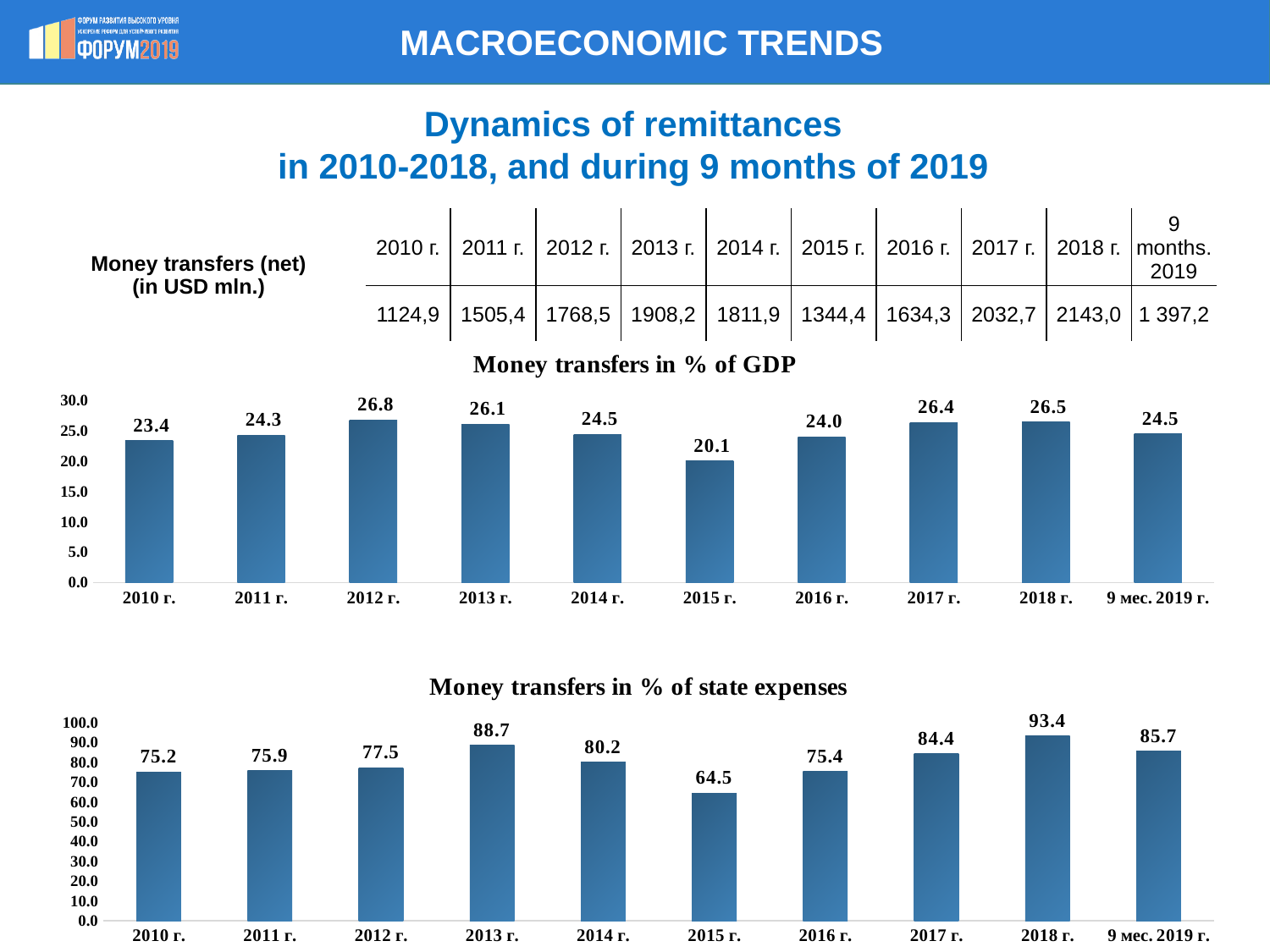
In the 'Money transfers in % of state expenses' chart, which category has the lowest value? 2015 г. In the 'Money transfers in % of state expenses' chart, is the value for 2017 г. larger or smaller than the value for 2014 г.? larger In the 'Money transfers in % of GDP' chart, what is the difference between the values for 2018 г. and 2015 г.? 6.4 What type of chart is 'Money transfers in % of state expenses'? bar chart In the 'Money transfers in % of GDP' chart, which category has the lowest value? 2015 г. In the 'Money transfers in % of state expenses' chart, what is the difference between the values for 2018 г. and 2010 г.? 18.2 In the 'Money transfers in % of GDP' chart, what is the value for 2012 г.? 26.8 In the 'Money transfers in % of GDP' chart, which category has the highest value? 2012 г. In the 'Money transfers in % of GDP' chart, do the values rise or fall from 2012 г. to 2015 г.? fall In the 'Money transfers in % of GDP' chart, how many bars are plotted? 10 In the 'Money transfers in % of state expenses' chart, which category has the highest value? 2018 г. In the 'Money transfers in % of state expenses' chart, what is the value for 2013 г.? 88.7